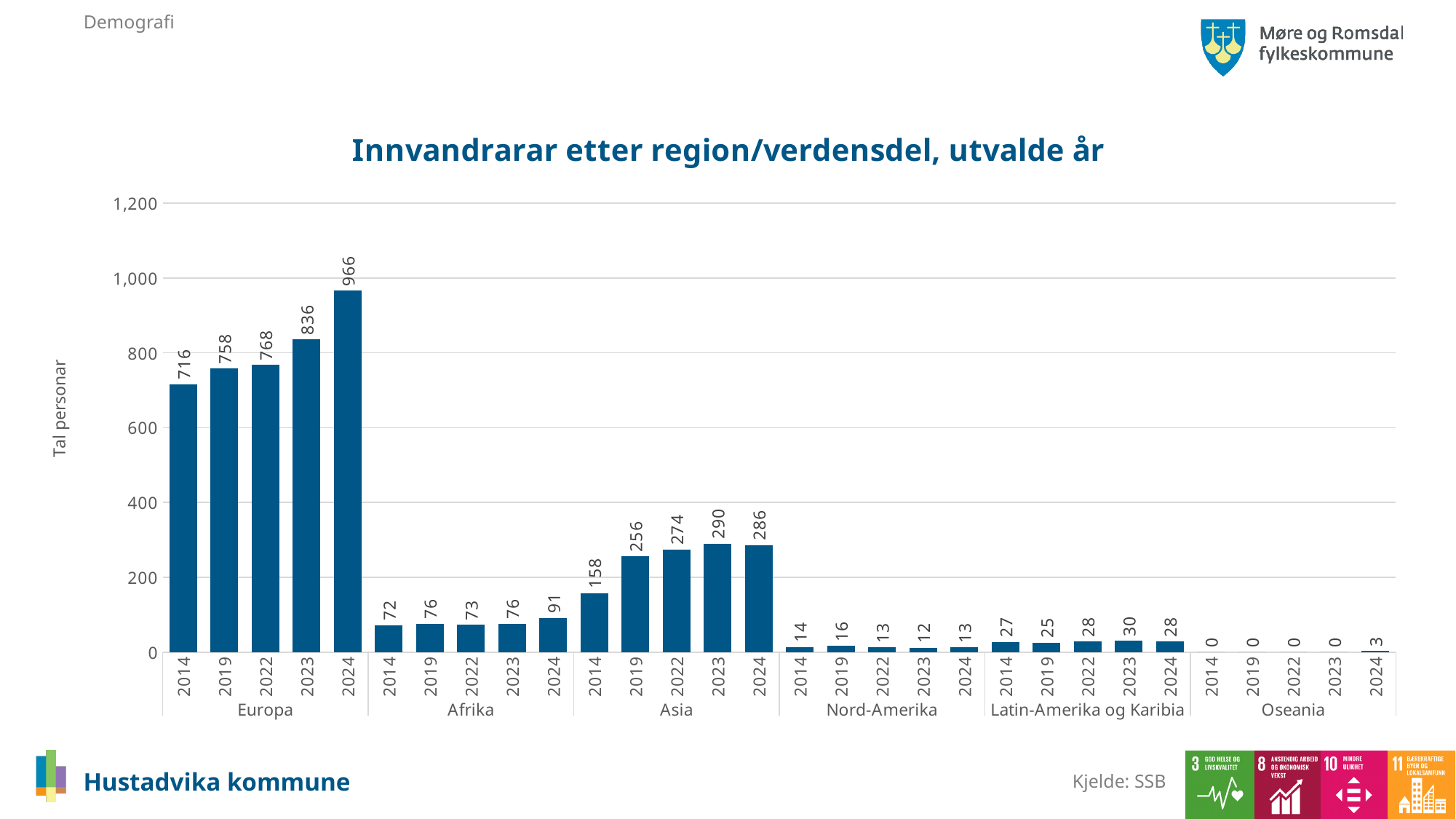
Do the Europa values rise or fall from 2014 to 2024? Rise What is the value for Oseania in 2024? 3 What kind of chart is shown on the slide? Bar chart Is the value for Europa in 2023 greater or less than 800? greater Which is larger, the Asia value for 2023 or the Asia value for 2024? Asia 2023 What is the value for Asia in 2019? 256 Which region has the lowest value in 2014? Oseania Which region has the highest bar in 2024? Europa What is the value for Afrika in 2024? 91 What is the difference between the Europa values for 2024 and 2014? 250 How many regions are shown on the x axis? 6 What is the value for Europa in 2024? 966